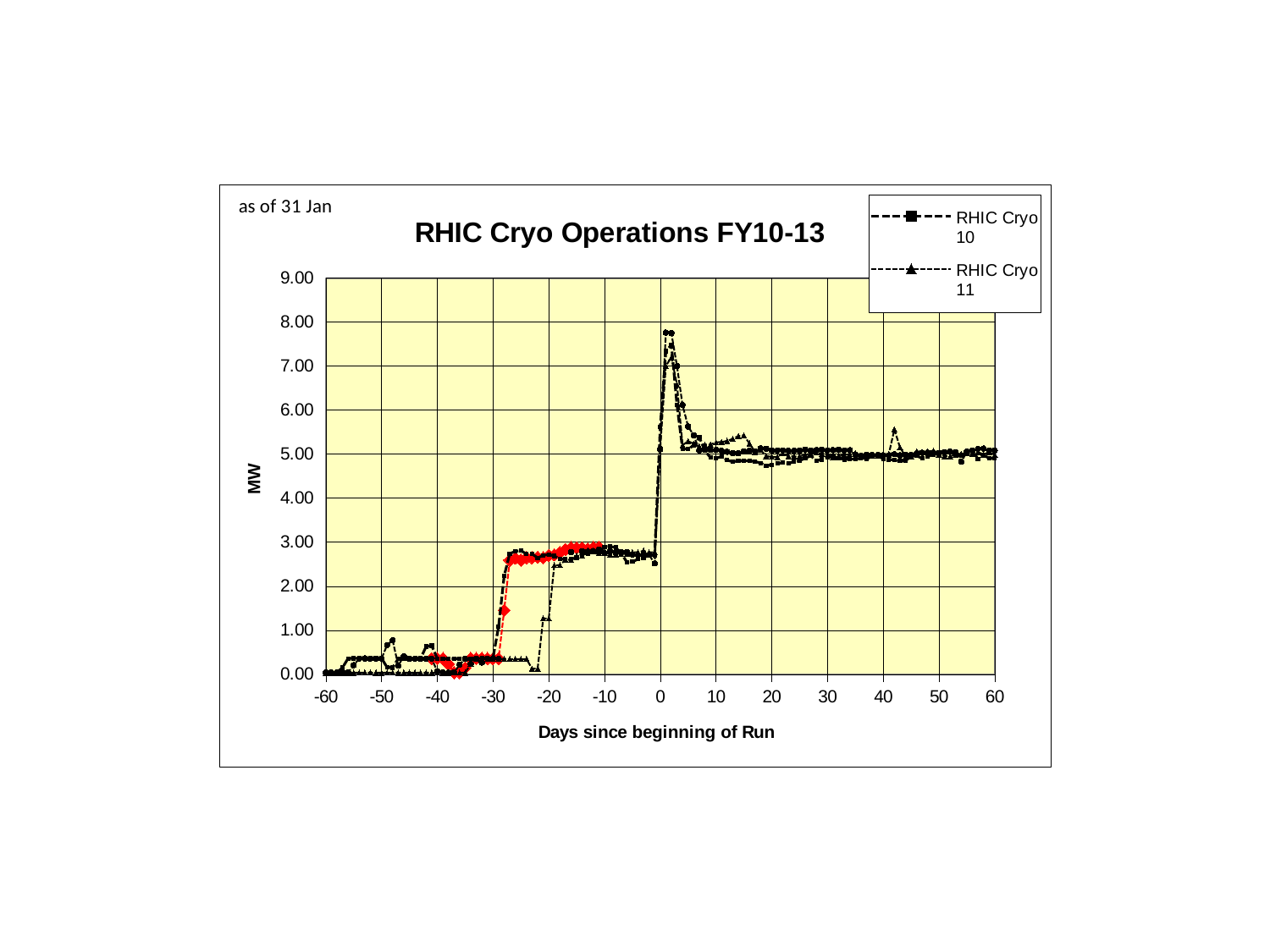
What kind of chart is shown on the slide? line chart Do the plotted values generally rise or fall between day -60 and day 0? rise What is the label of the chart's x axis? Days since beginning of Run What is the highest tick value shown on the y axis? 9.00 Is the value for RHIC Cryo 11 at day 30 greater or less than 6.00 MW? less Is the value for RHIC Cryo 10 at day -40 greater or less than 1.00 MW? less Is the highest value plotted on the chart greater or less than 7.00 MW? greater How many series does the chart's legend list? 2 What is the title of the chart? RHIC Cryo Operations FY10-13